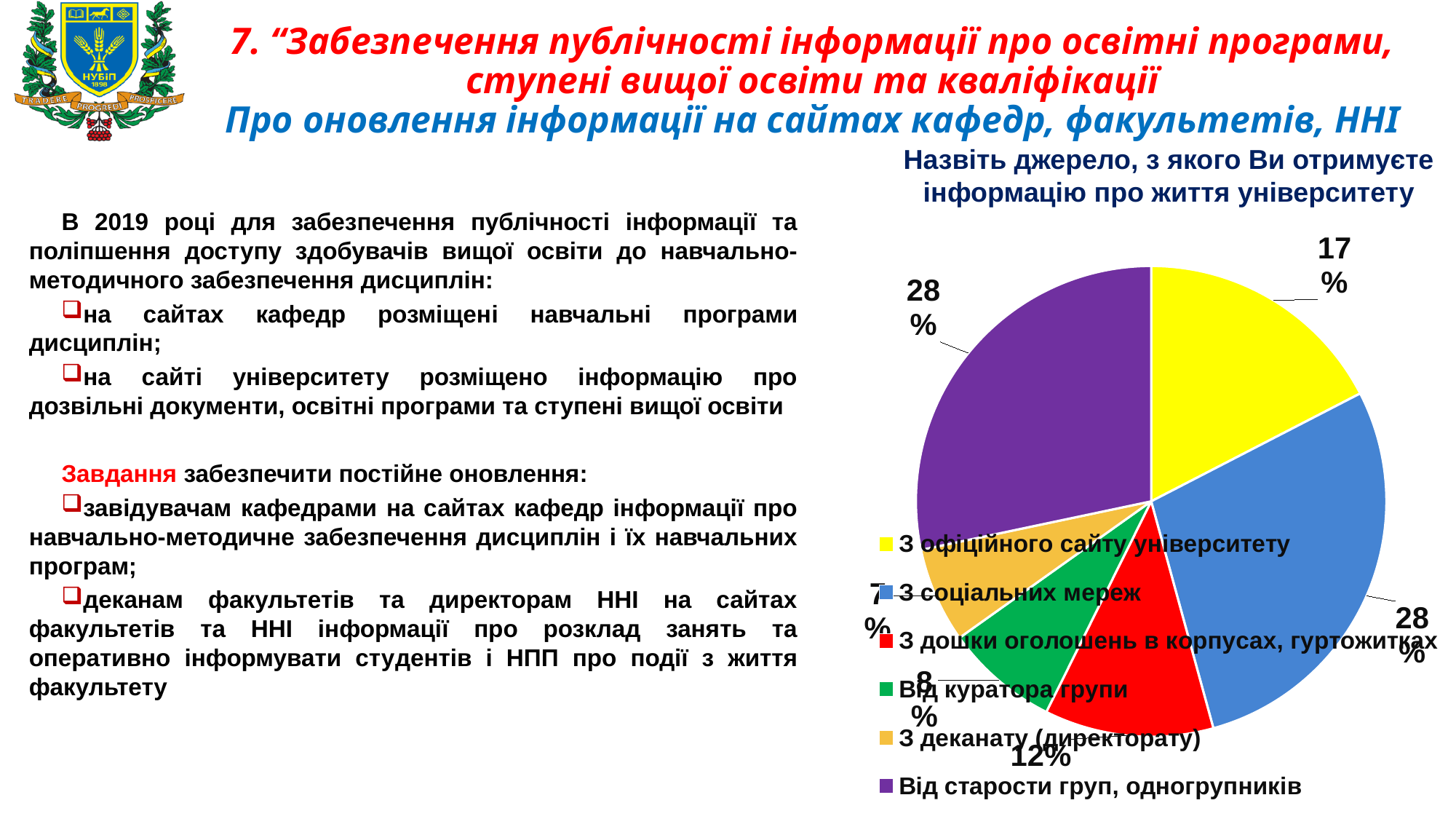
What share of the pie is 'Від куратора групи'? 8% What share of the pie is 'З офіційного сайту університету'? 17% What share of the pie is 'З соціальних мереж'? 28% How many entries does the legend of the pie chart list? 6 What is the difference between the shares for 'З соціальних мереж' and 'З офіційного сайту університету'? 11% What is the title of the pie chart? Назвіть джерело, з якого Ви отримуєте інформацію про життя університету Which is larger: the share for 'З дошки оголошень в корпусах, гуртожитках' or the share for 'Від куратора групи'? З дошки оголошень в корпусах, гуртожитках How many slices does the pie chart have? 6 Which source has the smallest share in the pie chart? З деканату (директорату) What kind of chart is shown on the slide? pie chart